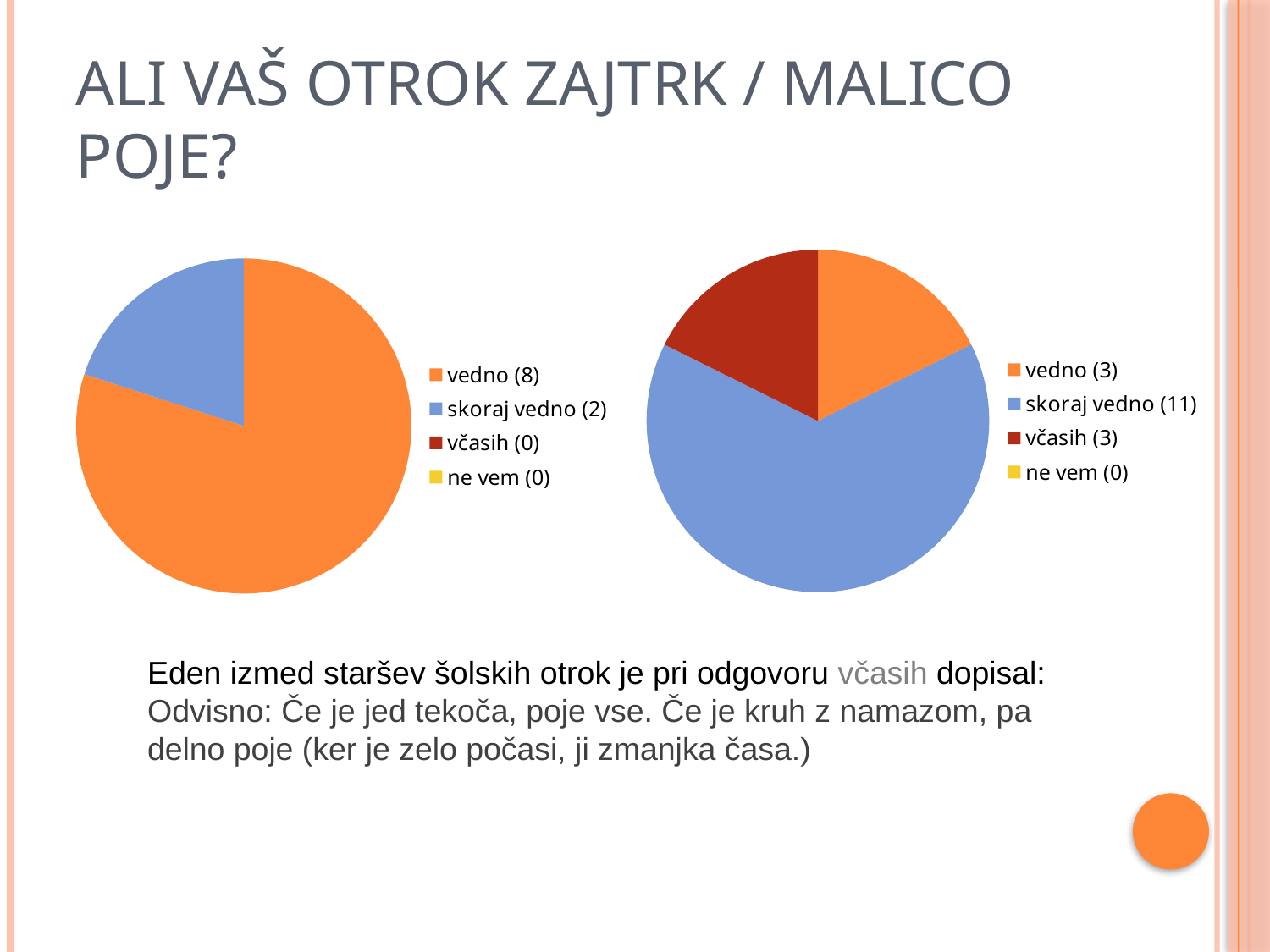
In the left pie chart, which category has the largest slice? vedno In the left pie chart, how many responses does the legend give for "skoraj vedno"? 2 In the right pie chart, how many responses does the legend give for "včasih"? 3 In the left pie chart, what is the difference between the counts for "vedno" and "skoraj vedno"? 6 What kind of charts are shown on the slide? Pie charts How many categories does the legend of the left pie chart list? 4 Which is larger in the right pie chart: the count for "vedno" or the count for "skoraj vedno"? skoraj vedno In the right pie chart, which category has the largest slice? skoraj vedno In the right pie chart, what is the difference between the counts for "skoraj vedno" and "vedno"? 8 In the right pie chart, how many responses does the legend give for "skoraj vedno"? 11 In the left pie chart, what share of the total responses does "vedno" represent? 80% In the left pie chart, how many responses does the legend give for "vedno"? 8